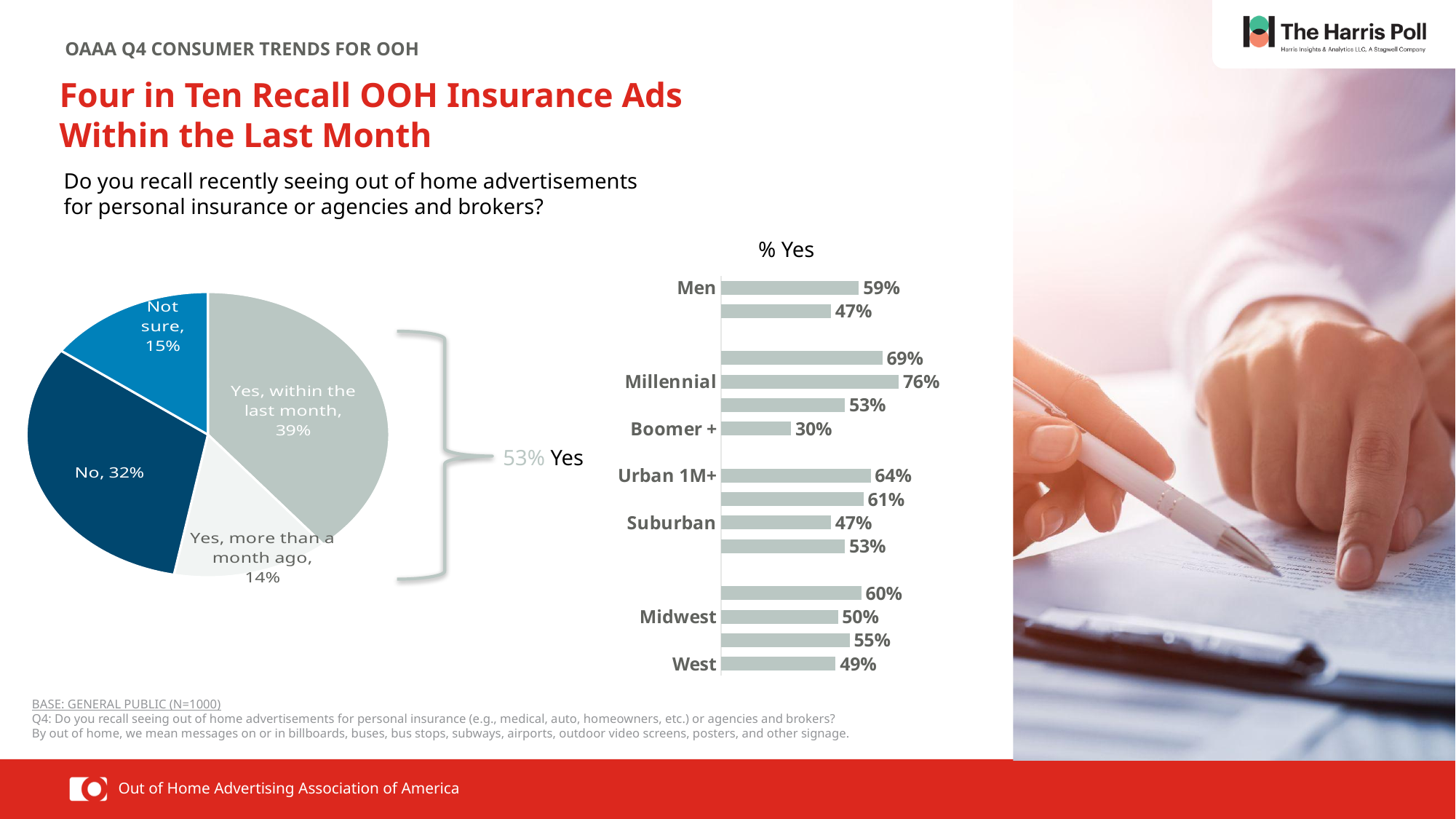
In the pie chart, how many slices are there? 4 In the '% Yes' bar chart, which is larger, Midwest or West? Midwest In the pie chart, which response has the smallest slice? Yes, more than a month ago What type of chart is the '% Yes' chart on the right? Bar chart In the pie chart, what is the combined share of the two 'Yes' slices shown by the bracket? 53% In the pie chart, what share of respondents said 'Yes, within the last month'? 39% In the '% Yes' bar chart, what is the value for Boomer +? 30% In the pie chart, what share of respondents answered 'No'? 32% In the '% Yes' bar chart, what is the difference between Urban 1M+ and Suburban? 17% In the '% Yes' bar chart, which labeled group has the lowest value? Boomer + In the pie chart, what is the difference between the 'No' share and the 'Not sure' share? 17% In the '% Yes' bar chart, what is the value for Millennial? 76%